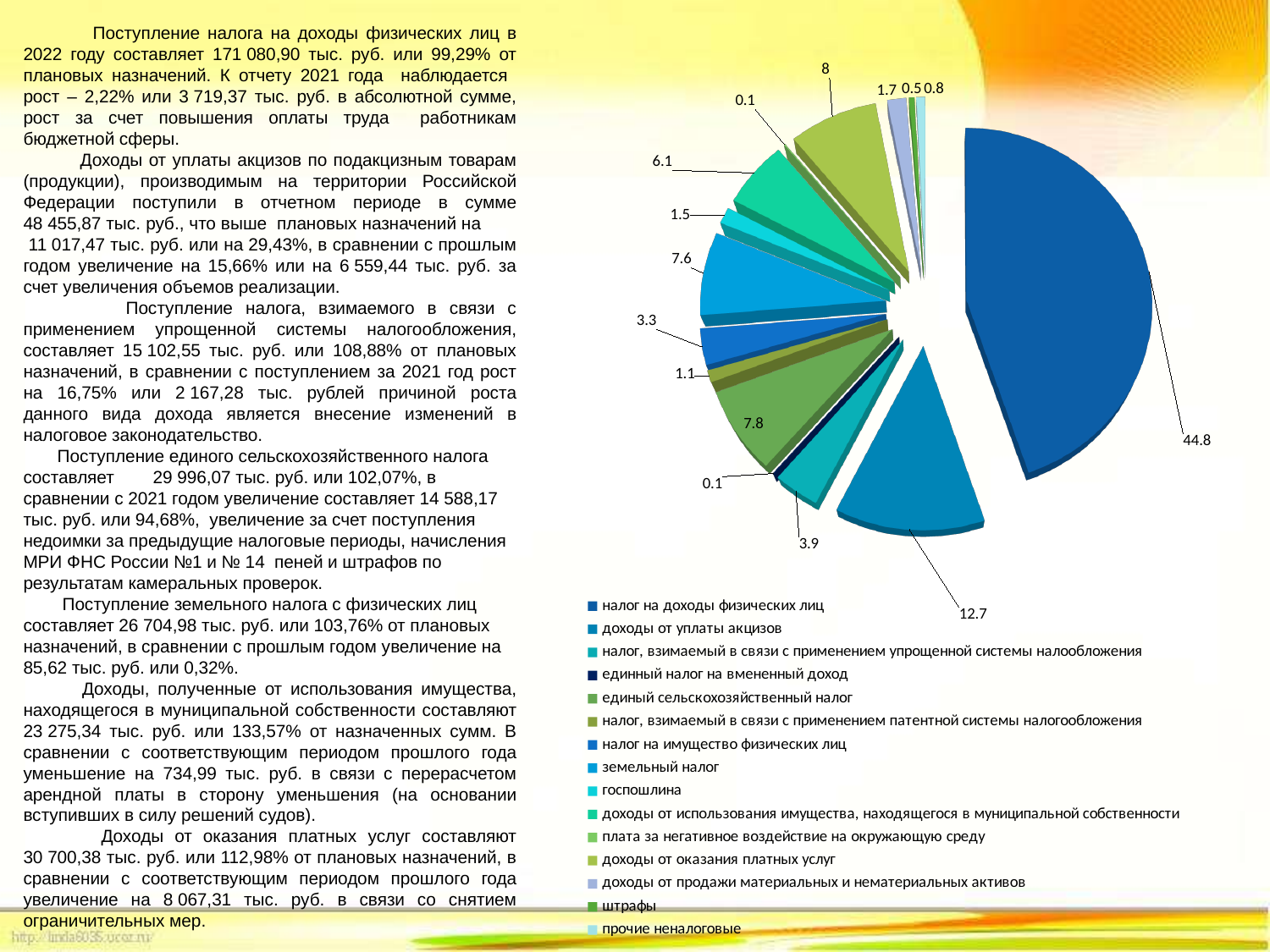
What is the value of the largest slice in the pie chart? 44.8 How many entries does the chart legend list? 15 What value is shown for налог на доходы физических лиц? 44.8 What value is shown for доходы от уплаты акцизов? 12.7 What kind of chart is shown on the slide? pie chart What value is shown for единый сельскохозяйственный налог? 7.8 What value is shown for доходы от оказания платных услуг? 8 Which category has the largest slice in the pie chart? налог на доходы физических лиц What is the second-largest value labelled on the pie chart? 12.7 What is the difference between the values for налог на доходы физических лиц and доходы от уплаты акцизов? 32.1 Which is larger: the slice for доходы от уплаты акцизов or the slice for доходы от оказания платных услуг? доходы от уплаты акцизов How many slices does the pie chart have? 15